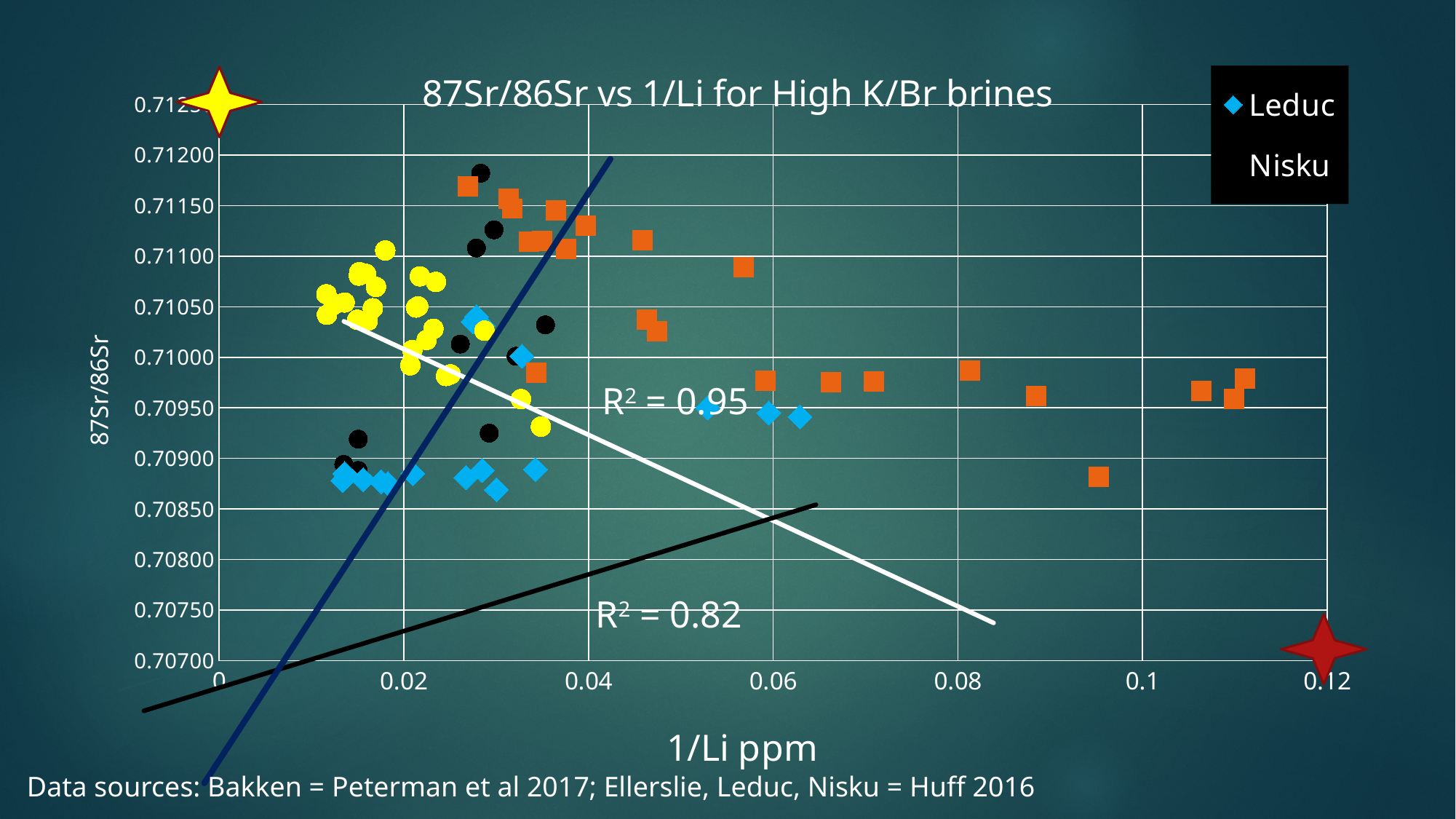
Which of the two printed R² values is larger, 0.95 or 0.82? 0.95 How many series does the chart's legend list? 2 Is the 87Sr/86Sr value of the Leduc points near 1/Li = 0.06 greater or less than 0.71000? less What is the title of the chart? 87Sr/86Sr vs 1/Li for High K/Br brines What is the maximum value shown on the x axis? 0.12 Is the 87Sr/86Sr value of the orange square point near 1/Li = 0.057 greater or less than 0.71050? greater Which series is shown with blue diamond markers according to the legend? Leduc What kind of chart is shown on the slide? scatter chart What is the label of the y axis? 87Sr/86Sr What is the label of the x axis? 1/Li ppm What R² value is printed for the upper (white) trend line? R² = 0.95 What R² value is printed for the lower (black) trend line? R² = 0.82